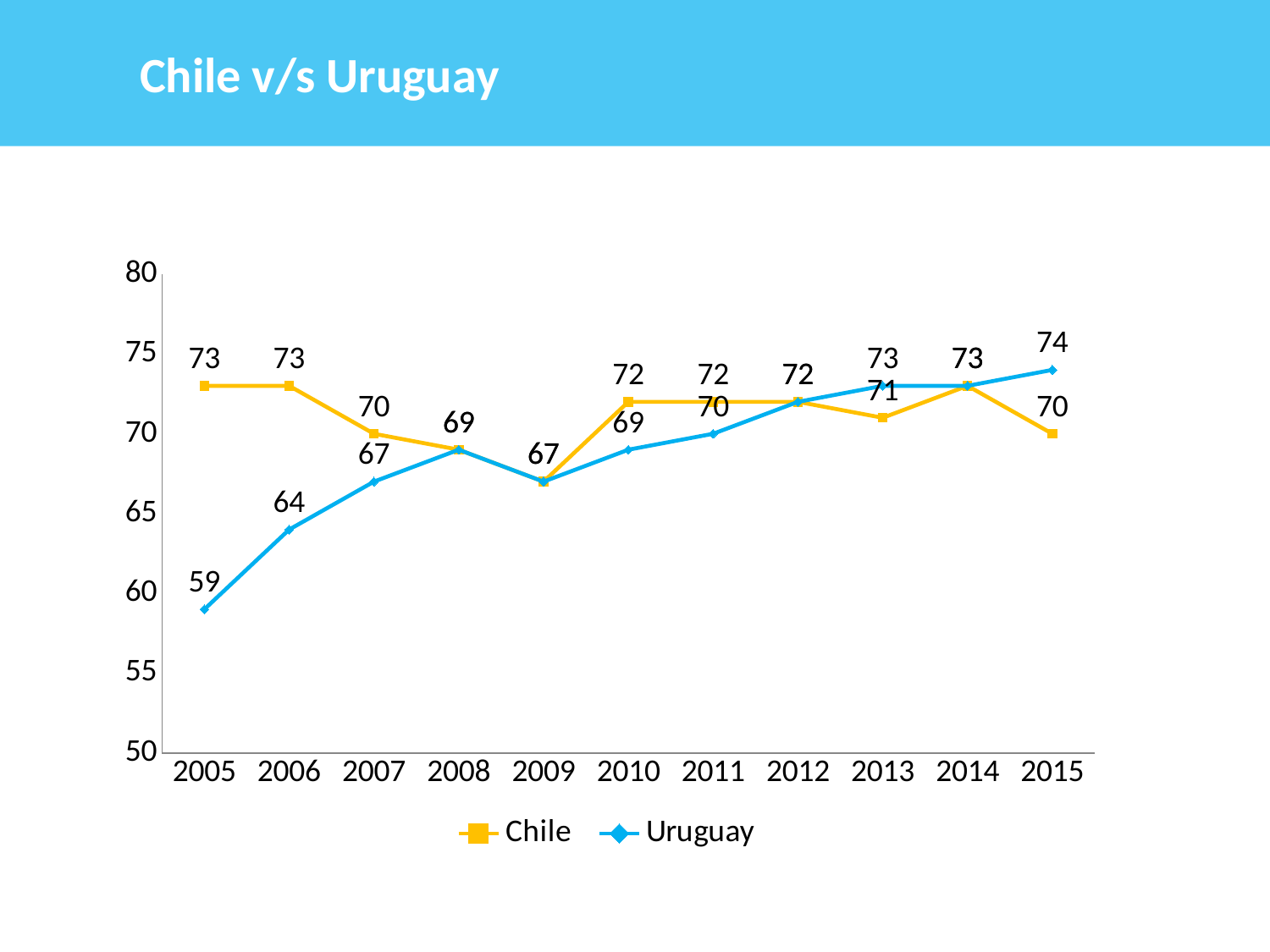
What is the value for Uruguay in 2005? 59 What is the difference between the Chile and Uruguay values in 2015? 4 In which year is the Uruguay value lowest? 2005 What is the difference between the Chile and Uruguay values in 2005? 14 How many years are shown on the x axis? 11 What kind of chart is shown on the slide? Line chart What is the value for Chile in 2009? 67 How many series does the legend list? 2 What is the value for Uruguay in 2015? 74 What is the value for Chile in 2013? 71 Which series has the larger value in 2010, Chile or Uruguay? Chile In which year is the Uruguay value highest? 2015